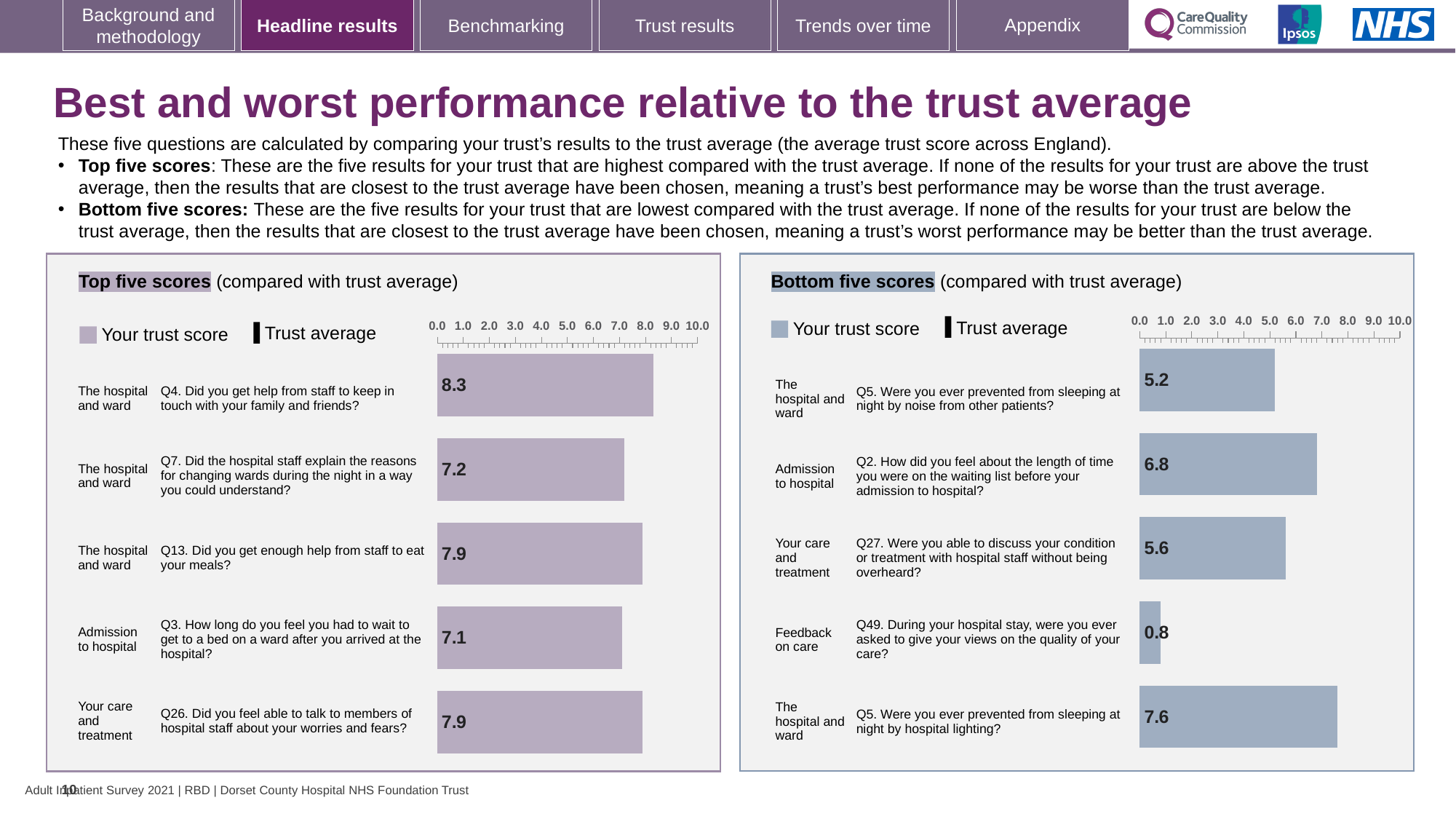
In the Bottom five scores chart, which question has the lowest trust score? Q49 How many questions are plotted in the Top five scores chart? 5 In the Bottom five scores chart, what is the trust score for Q49 (asked to give your views on the quality of your care)? 0.8 What kind of chart is used in the Bottom five scores panel? Bar chart In the Top five scores chart, which question has the highest trust score? Q4 In the Top five scores chart, what is the trust score for Q3 (how long you had to wait to get to a bed on a ward)? 7.1 In the Bottom five scores chart, which question has the highest trust score? Q5 (prevented from sleeping at night by hospital lighting) In the Top five scores chart, what is the difference between the trust scores for Q4 and Q7? 1.1 In the Bottom five scores chart, what is the trust score for Q2 (length of time on the waiting list before admission)? 6.8 In the Bottom five scores chart, what is the difference between the trust scores for Q2 and Q27? 1.2 In the Bottom five scores chart, which has the larger trust score: Q5 about noise from other patients or Q27 about discussing your condition without being overheard? Q27 In the Top five scores chart, what is the trust score for Q4 (help from staff to keep in touch with family and friends)? 8.3